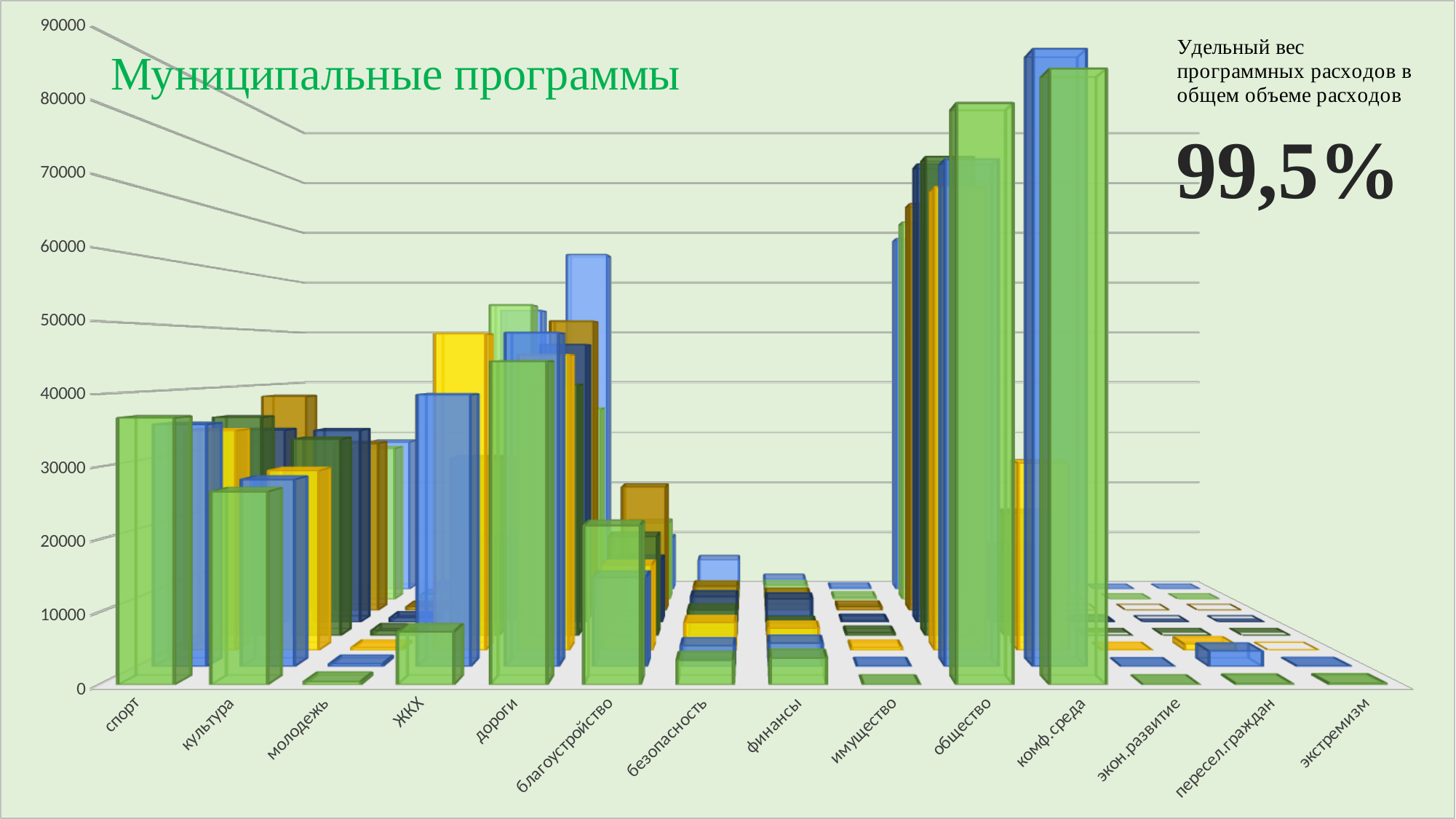
What kind of chart is shown on the slide? bar chart Which category has larger values, комф.среда or безопасность? комф.среда Are the bars for финансы greater or less than 20000? less Is the tallest bar for комф.среда greater or less than 60000? greater What is the title of the chart? Муниципальные программы Are the bars for экстремизм greater or less than 10000? less How many categories are shown along the x axis of the chart? 14 Which category has larger values, общество or финансы? общество What percentage is shown on the slide for the share of programme expenditures in total expenditures (Удельный вес программных расходов в общем объеме расходов)? 99,5% Which category has the tallest bars in the chart? комф.среда